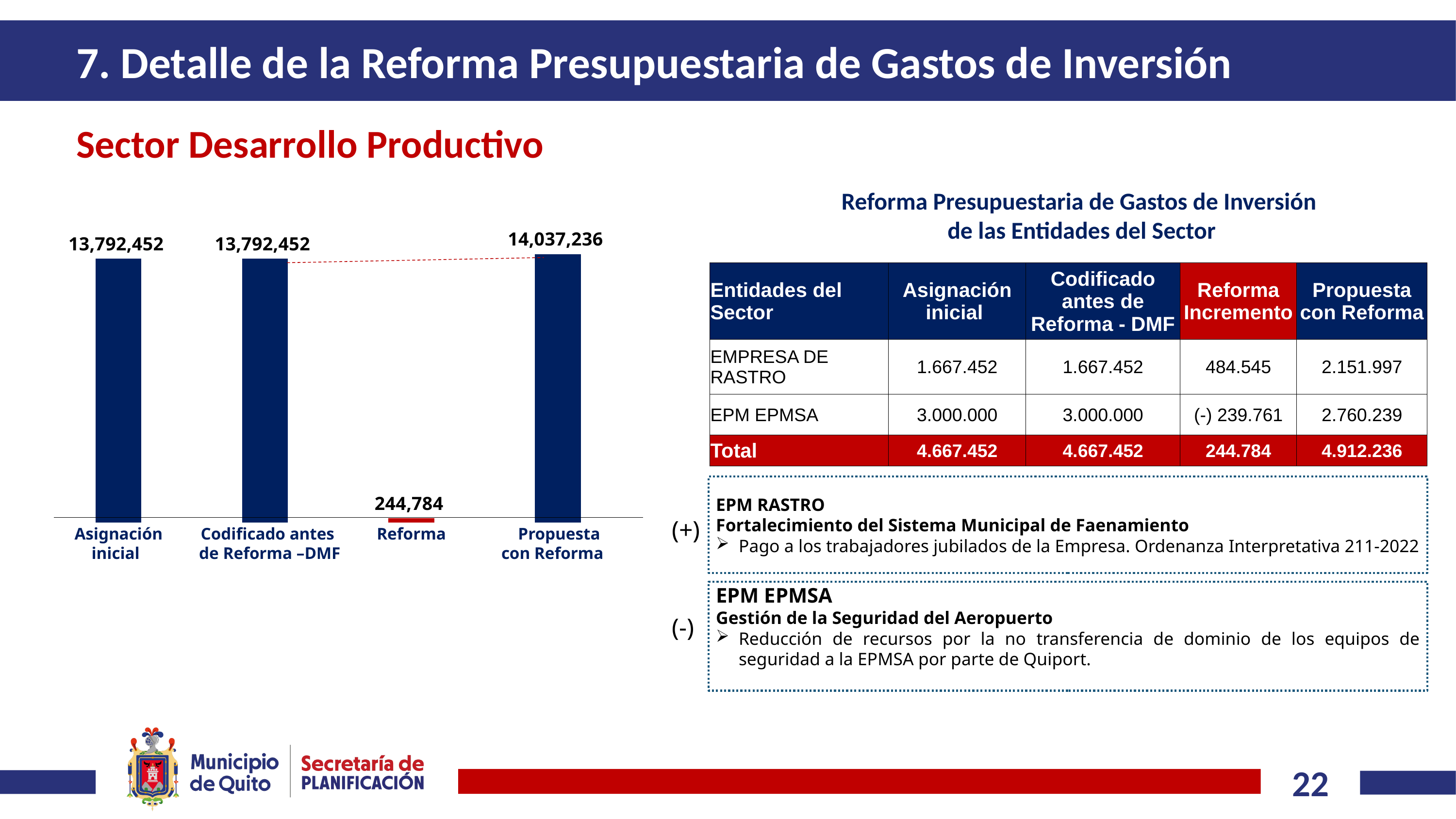
Are the values for Asignación inicial and Codificado antes de Reforma –DMF equal in the chart? Yes Which category has the highest value in the chart? Propuesta con Reforma Which is larger in the chart, Propuesta con Reforma or Asignación inicial? Propuesta con Reforma What is the difference between Propuesta con Reforma and Codificado antes de Reforma –DMF in the chart? 244,784 What colour is the Reforma bar in the chart? Red What is the value shown for Codificado antes de Reforma –DMF in the chart? 13,792,452 What is the value shown for Asignación inicial in the chart? 13,792,452 What is the value shown for Propuesta con Reforma in the chart? 14,037,236 What kind of chart is shown on the slide? Bar chart How many categories are shown on the x axis of the chart? 4 What is the value shown for Reforma in the chart? 244,784 Which category has the lowest value in the chart? Reforma